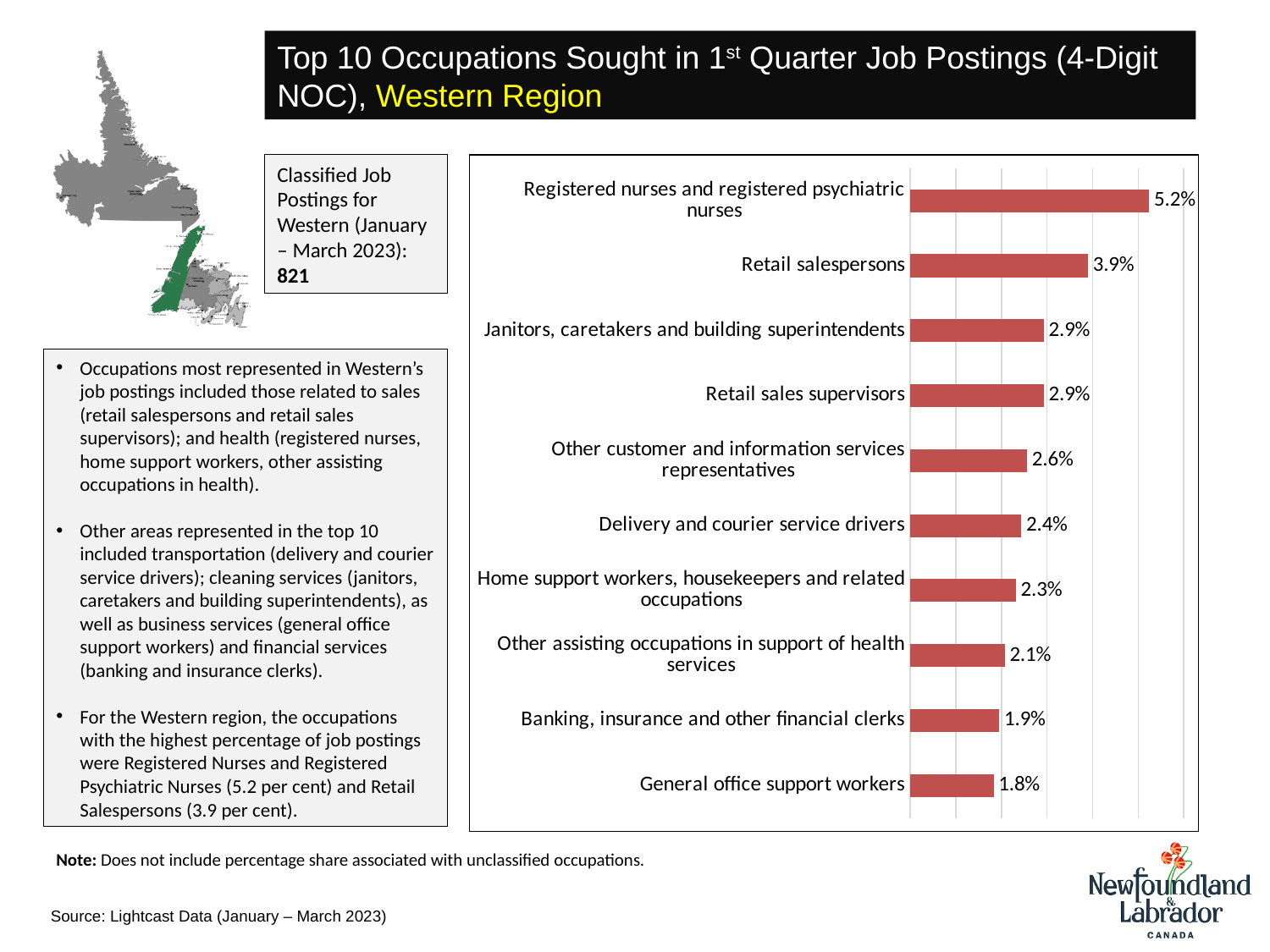
What percentage of job postings is shown for Registered nurses and registered psychiatric nurses? 5.2% How many occupations are shown in the chart? 10 What is the value for Retail salespersons? 3.9% Which has a larger value: Other customer and information services representatives or Home support workers, housekeepers and related occupations? Other customer and information services representatives What is the difference between the values for Registered nurses and registered psychiatric nurses and Retail salespersons? 1.3% Which occupation has the highest percentage of job postings? Registered nurses and registered psychiatric nurses What kind of chart is shown on the slide? Bar chart What is the value for General office support workers? 1.8% Which occupation has the lowest percentage of job postings? General office support workers What is the difference between the values for Banking, insurance and other financial clerks and General office support workers? 0.1% What is the value for Other assisting occupations in support of health services? 2.1% What is the value for Delivery and courier service drivers? 2.4%